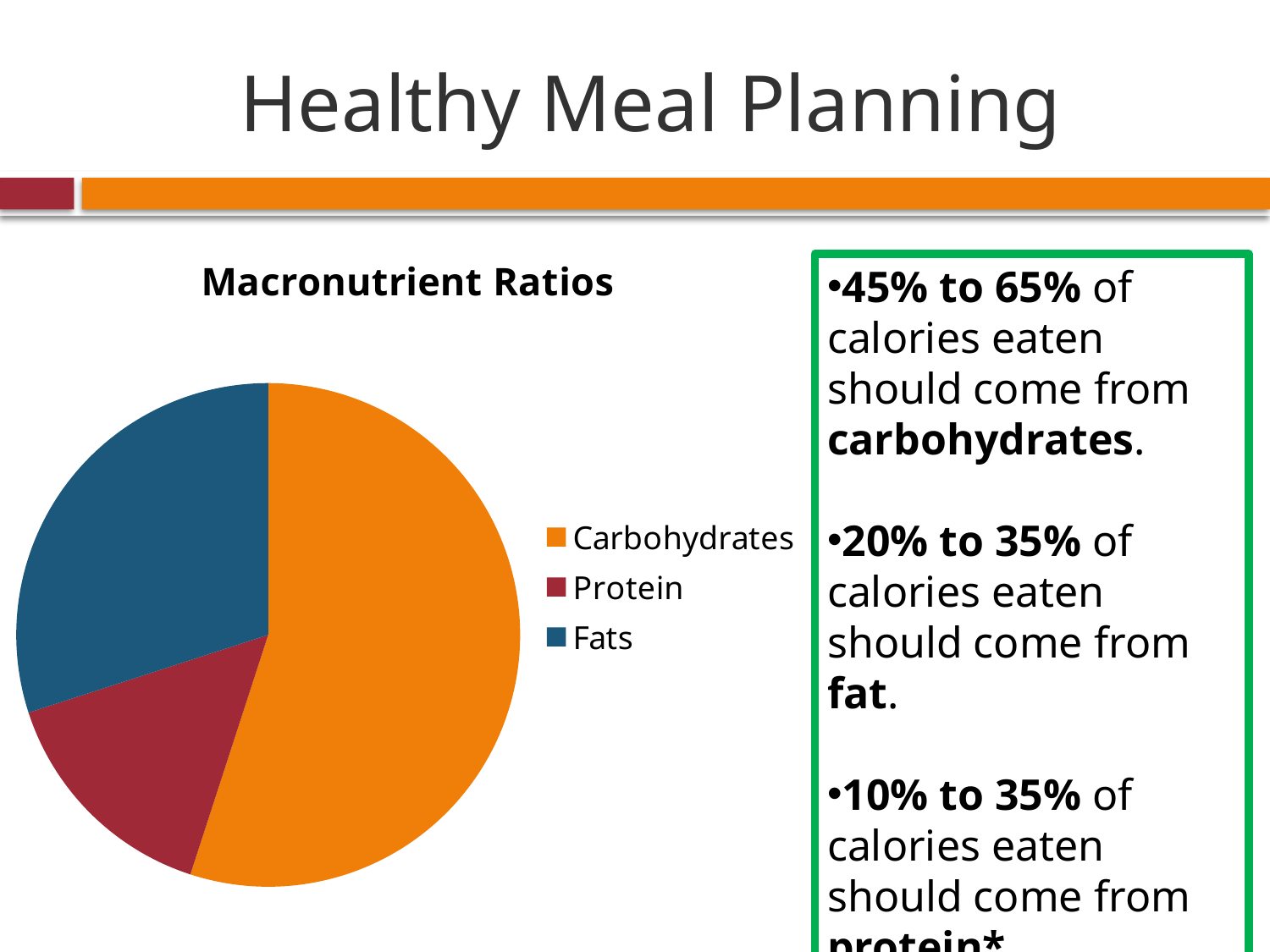
How many slices does the pie chart have? 3 Which category has the smallest slice of the pie? Protein Which category has the largest slice of the pie? Carbohydrates Which slice is larger, Carbohydrates or Fats? Carbohydrates How many entries does the chart legend list? 3 What kind of chart is shown on the slide? pie chart What colour is the Fats slice in the pie chart? blue Which slice is larger, Fats or Protein? Fats What is the title of the chart? Macronutrient Ratios